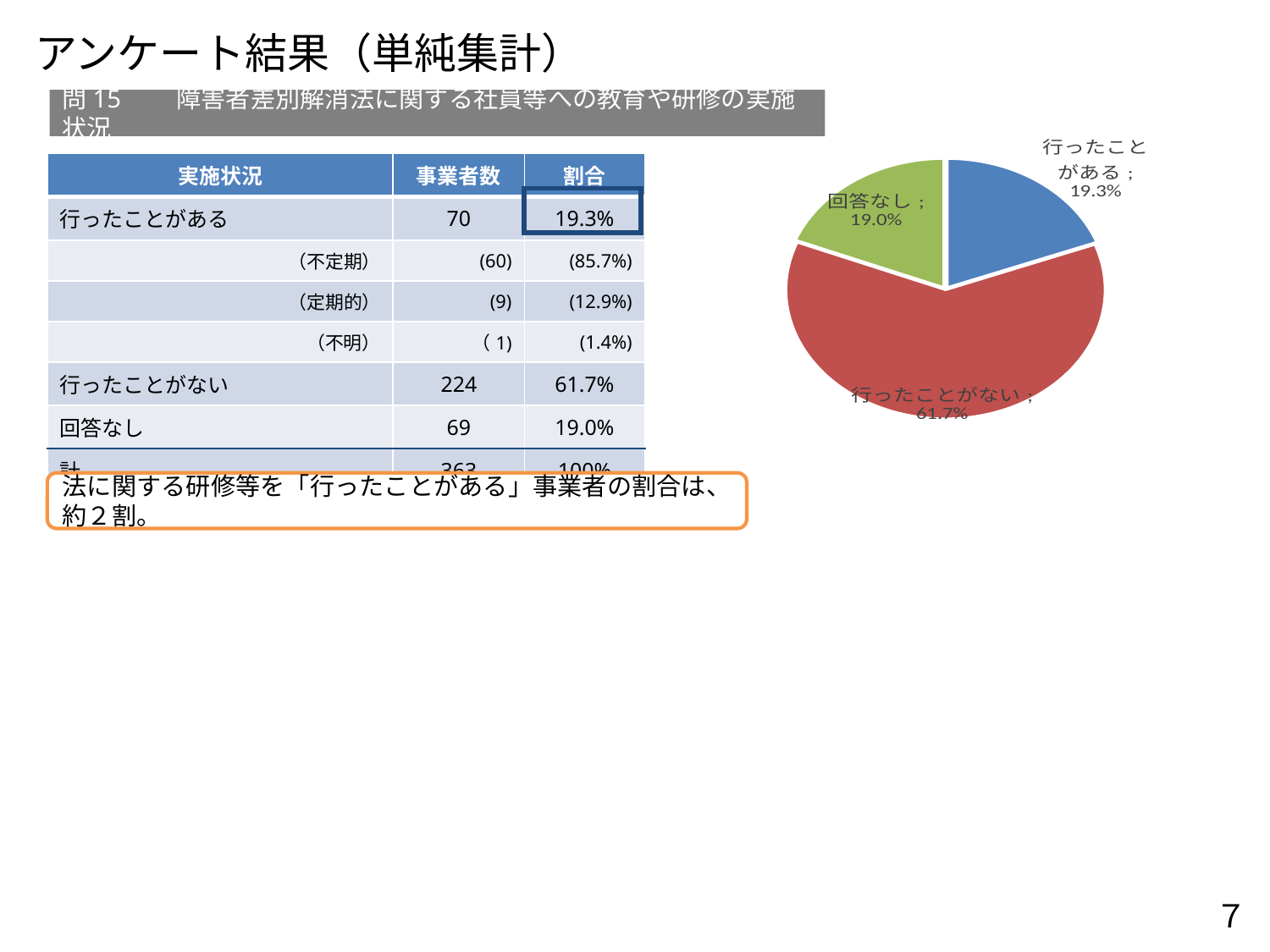
What percentage is shown for 行ったことがある in the pie chart? 19.3% What percentage is shown for 回答なし in the pie chart? 19.0% Which category has the largest slice in the pie chart? 行ったことがない What type of chart is shown on the slide? pie chart What share of the pie chart does 行ったことがない represent? 61.7% What colour is the slice for 回答なし in the pie chart? green What is the difference in percentage points between 行ったことがない and 回答なし in the pie chart? 42.7 How many slices does the pie chart have? 3 Is the slice for 回答なし larger or smaller than the slice for 行ったことがない? smaller Is the slice for 行ったことがない larger or smaller than the slice for 行ったことがある? larger What is the difference in percentage points between 行ったことがない and 行ったことがある in the pie chart? 42.4 What colour is the slice for 行ったことがない in the pie chart? red